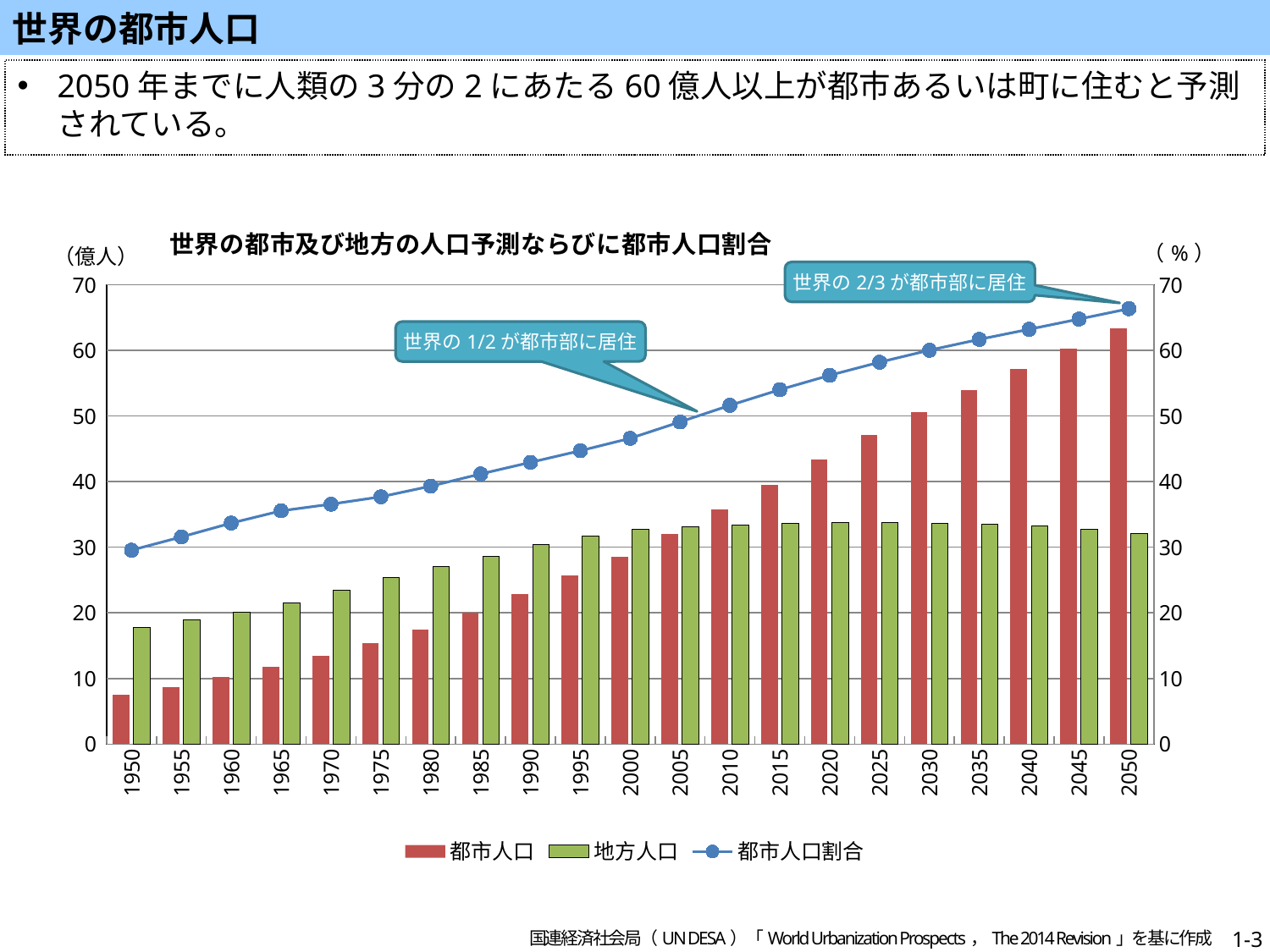
Is the 都市人口割合 value for 2050 greater or less than 60? greater How many series does the legend list? 3 In which year is 都市人口 (urban population) lowest? 1950 How many years are shown along the x axis? 21 What kind of chart is shown on the slide? A combined bar and line chart What is the title of the chart? 世界の都市及び地方の人口予測ならびに都市人口割合 Is the 地方人口 value for 1950 greater or less than 20? less Is the 都市人口 value for 2050 greater or less than 60? greater Does 都市人口割合 (urban population share) rise or fall from 1950 to 2050? Rise In which year is 都市人口 (urban population) highest? 2050 In 2050, which is larger, 都市人口 or 地方人口? 都市人口 In 2000, which is larger, 都市人口 or 地方人口? 地方人口